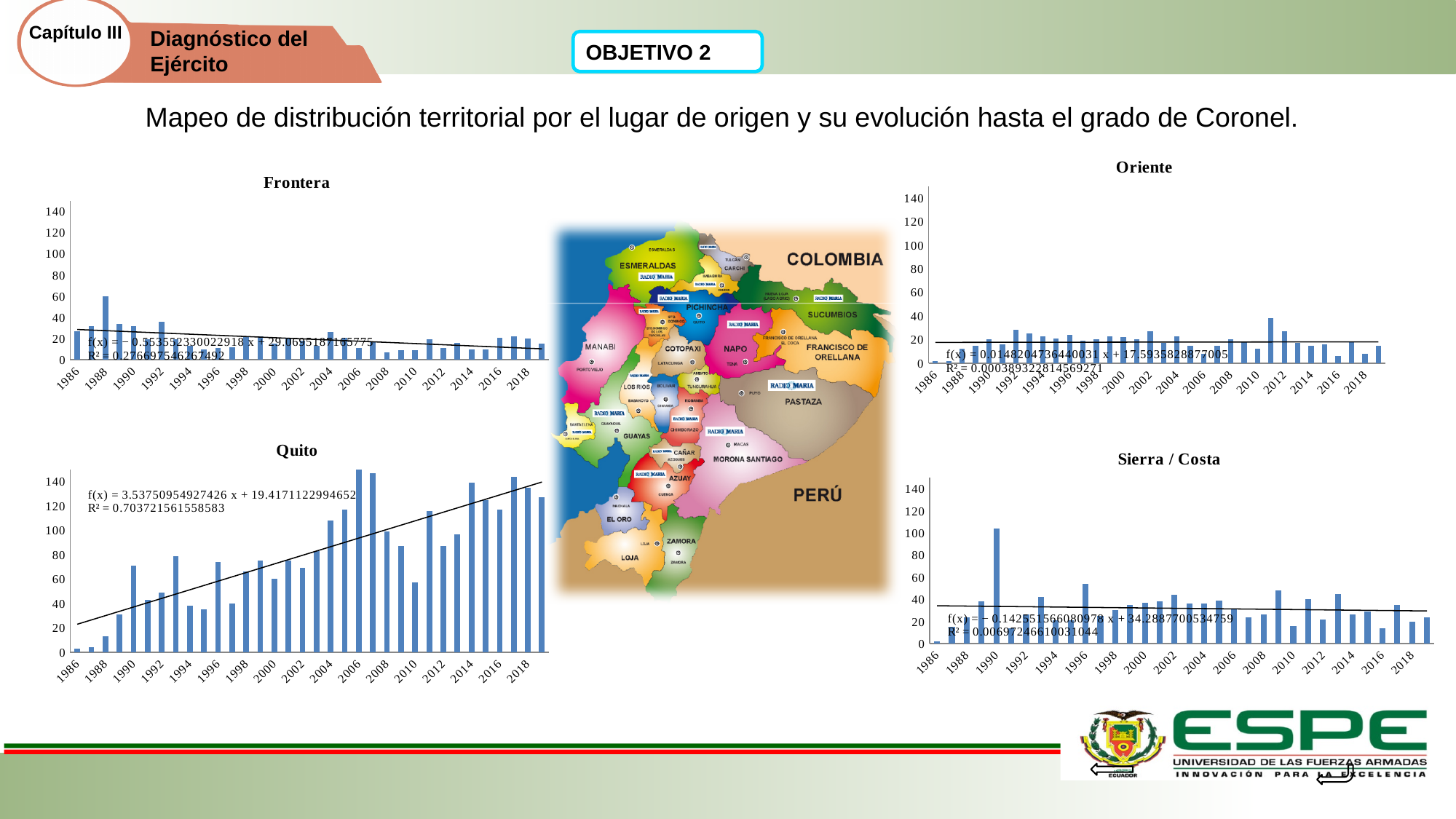
In the 'Quito' chart, which is larger, the value for 2014 or the value for 1990? 2014 In the 'Sierra / Costa' chart, which year has the highest value? 1990 What kind of chart is the 'Quito' chart? bar chart In the 'Frontera' chart, is the value for 1988 greater or less than 40? greater In the 'Sierra / Costa' chart, is the value for 1990 greater or less than 100? greater In the 'Quito' chart, is the value for 2006 greater or less than 140? greater In the 'Quito' chart, do the values generally rise or fall from 1986 to 2018? rise In the 'Frontera' chart, which year has the highest value? 1988 What R² value is printed on the 'Quito' chart? 0.703721561558583 What are the titles of the four bar charts on the slide? Frontera, Oriente, Quito, Sierra / Costa In the 'Oriente' chart, which year has the highest value? 2011